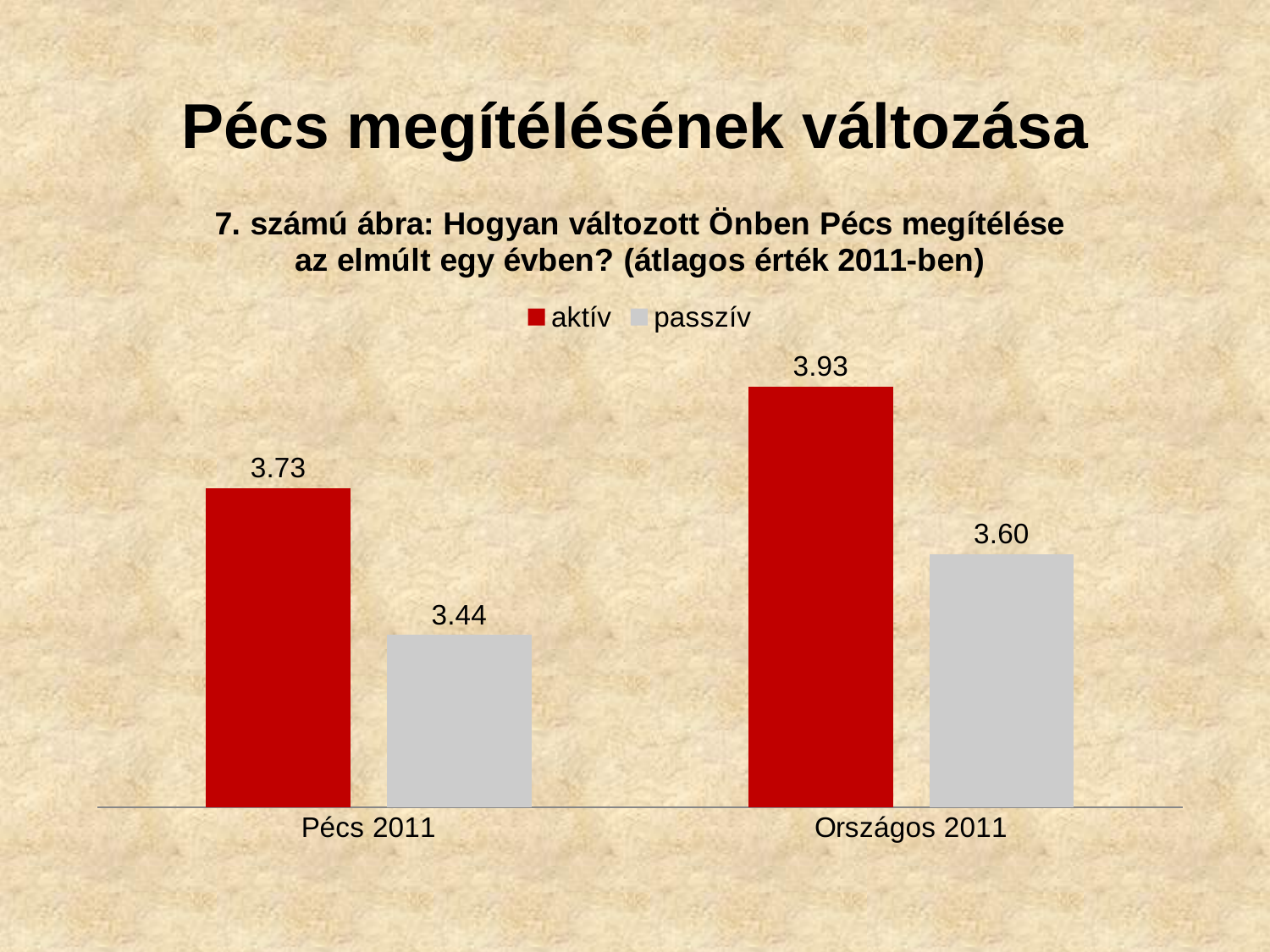
Which bar has the highest value on the chart? aktív, Országos 2011 How many categories are shown on the x axis? 2 What is the value for aktív in Pécs 2011? 3.73 Which bar has the lowest value on the chart? passzív, Pécs 2011 Which is larger, the passzív value for Pécs 2011 or the passzív value for Országos 2011? Országos 2011 What is the value for passzív in Pécs 2011? 3.44 What is the difference between the aktív values for Országos 2011 and Pécs 2011? 0.20 What is the value for passzív in Országos 2011? 3.60 What is the difference between the aktív and passzív values for Pécs 2011? 0.29 What kind of chart is shown on the slide? bar chart How many series does the legend list? 2 What is the value for aktív in Országos 2011? 3.93